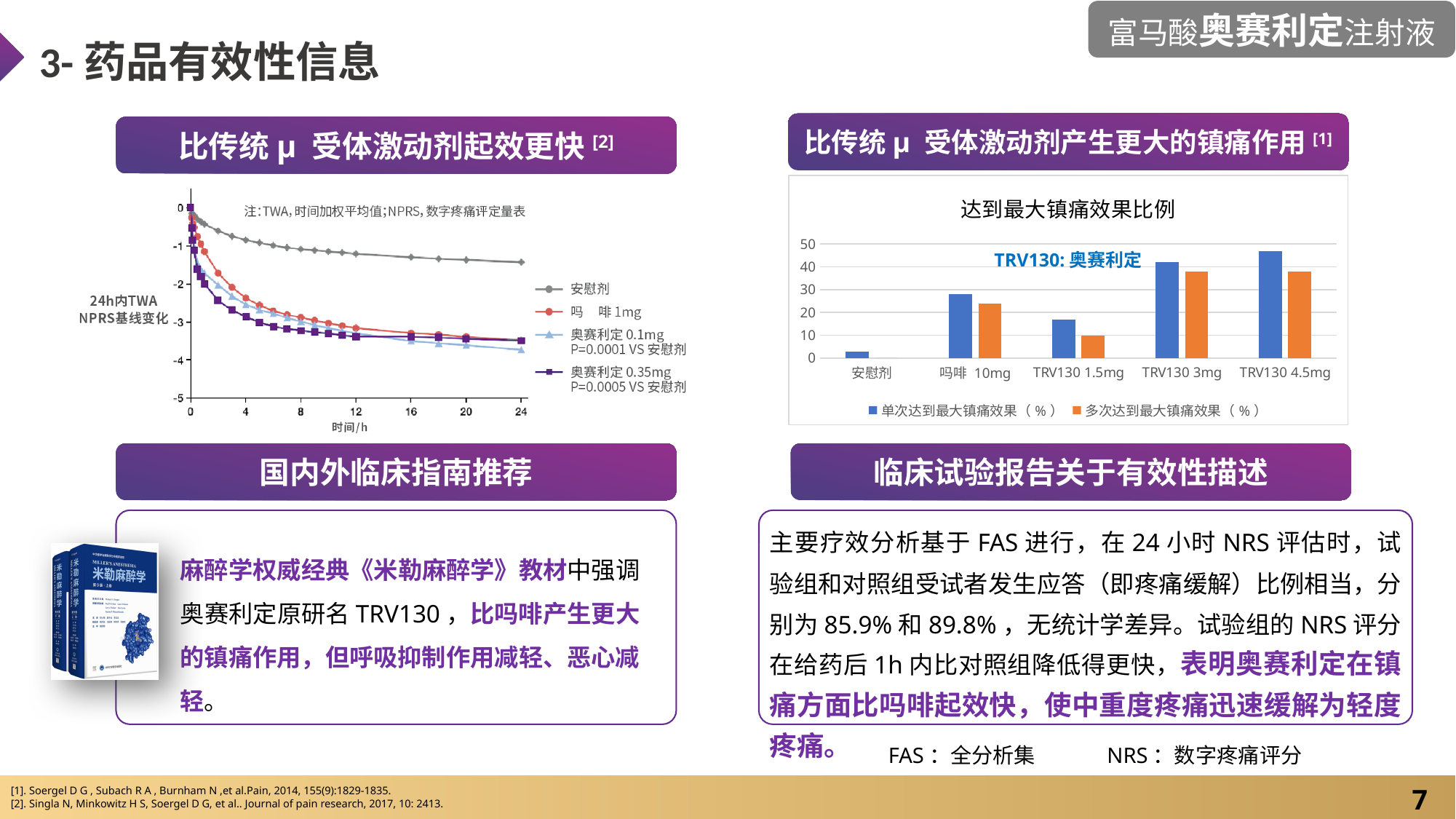
In the chart titled 达到最大镇痛效果比例, is the 多次达到最大镇痛效果（%） value for TRV130 1.5mg greater or less than 20? less In the line chart on the left, which series shows the smallest change from baseline at 24 h: 安慰剂 or 奥赛利定 0.35mg? 安慰剂 In the chart titled 达到最大镇痛效果比例, which has the larger 单次达到最大镇痛效果（%） value: 吗啡 10mg or TRV130 1.5mg? 吗啡 10mg In the chart titled 达到最大镇痛效果比例, how many series does the legend list? 2 What kind of chart is the chart on the left showing 24h内TWA NPRS基线变化? line chart In the line chart on the left, how many series does the legend list? 4 In the chart titled 达到最大镇痛效果比例, is the 单次达到最大镇痛效果（%） value for TRV130 4.5mg greater or less than 40? greater In the chart titled 达到最大镇痛效果比例, which category has the lowest value for 单次达到最大镇痛效果（%）? 安慰剂 In the chart titled 达到最大镇痛效果比例, which category has the highest value for 单次达到最大镇痛效果（%）? TRV130 4.5mg In the chart titled 达到最大镇痛效果比例, how many categories are shown on the x axis? 5 In the line chart on the left, do the values for 奥赛利定 0.35mg rise or fall as time (时间/h) increases? fall What kind of chart is the chart titled 达到最大镇痛效果比例 on the right? bar chart